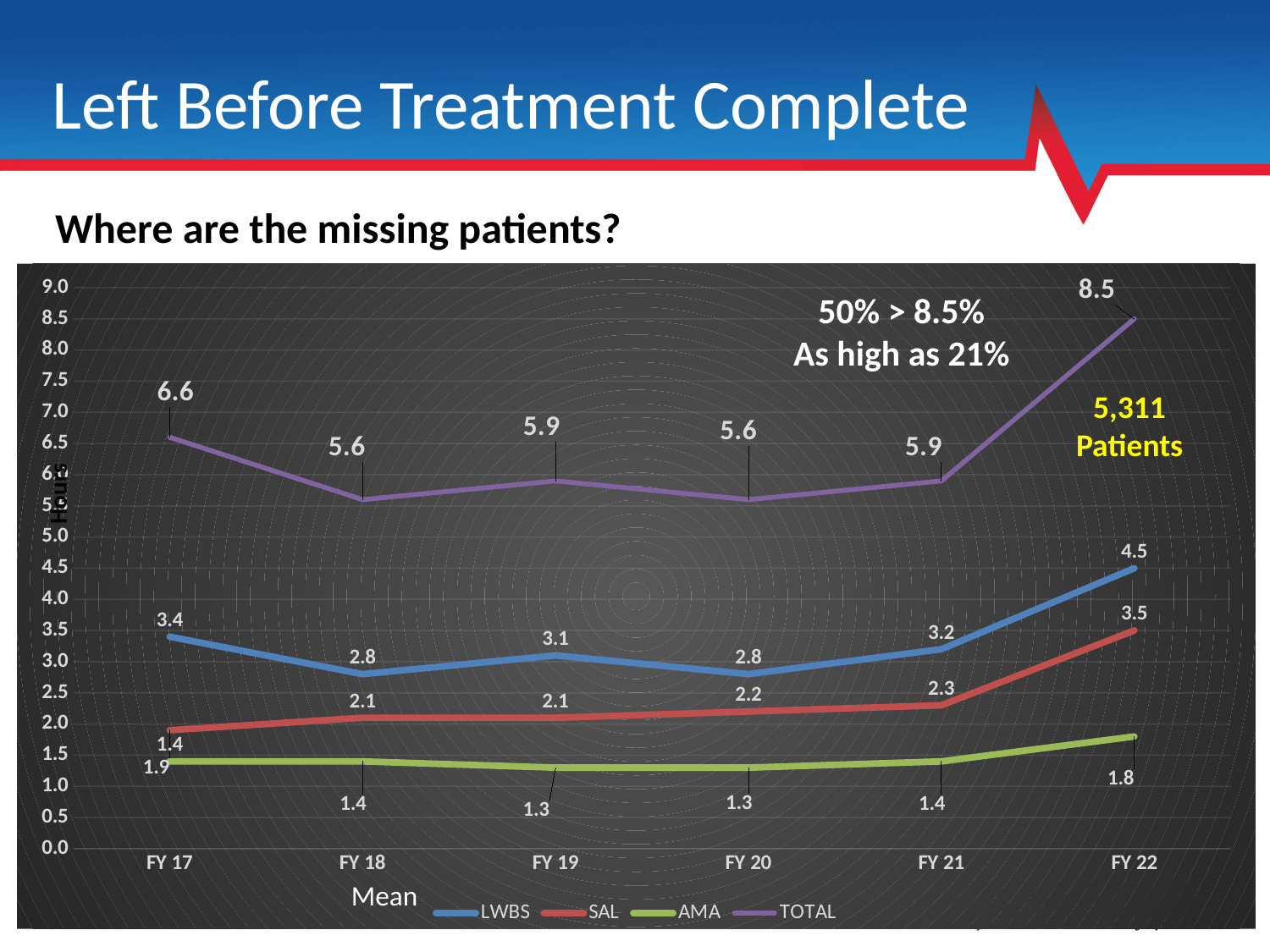
What is the title of the y axis? Hours What is the AMA value for FY 22? 1.8 How many fiscal years are plotted along the x axis? 6 What is the TOTAL value for FY 22? 8.5 What kind of chart is shown on the slide? line chart Which is larger, the LWBS value for FY 19 or for FY 18? FY 19 How many series does the legend list? 4 What is the SAL value for FY 21? 2.3 In which fiscal year is the TOTAL series highest? FY 22 What is the difference between the TOTAL values for FY 22 and FY 17? 1.9 What is the LWBS value for FY 22? 4.5 Does the TOTAL series rise or fall from FY 21 to FY 22? rise